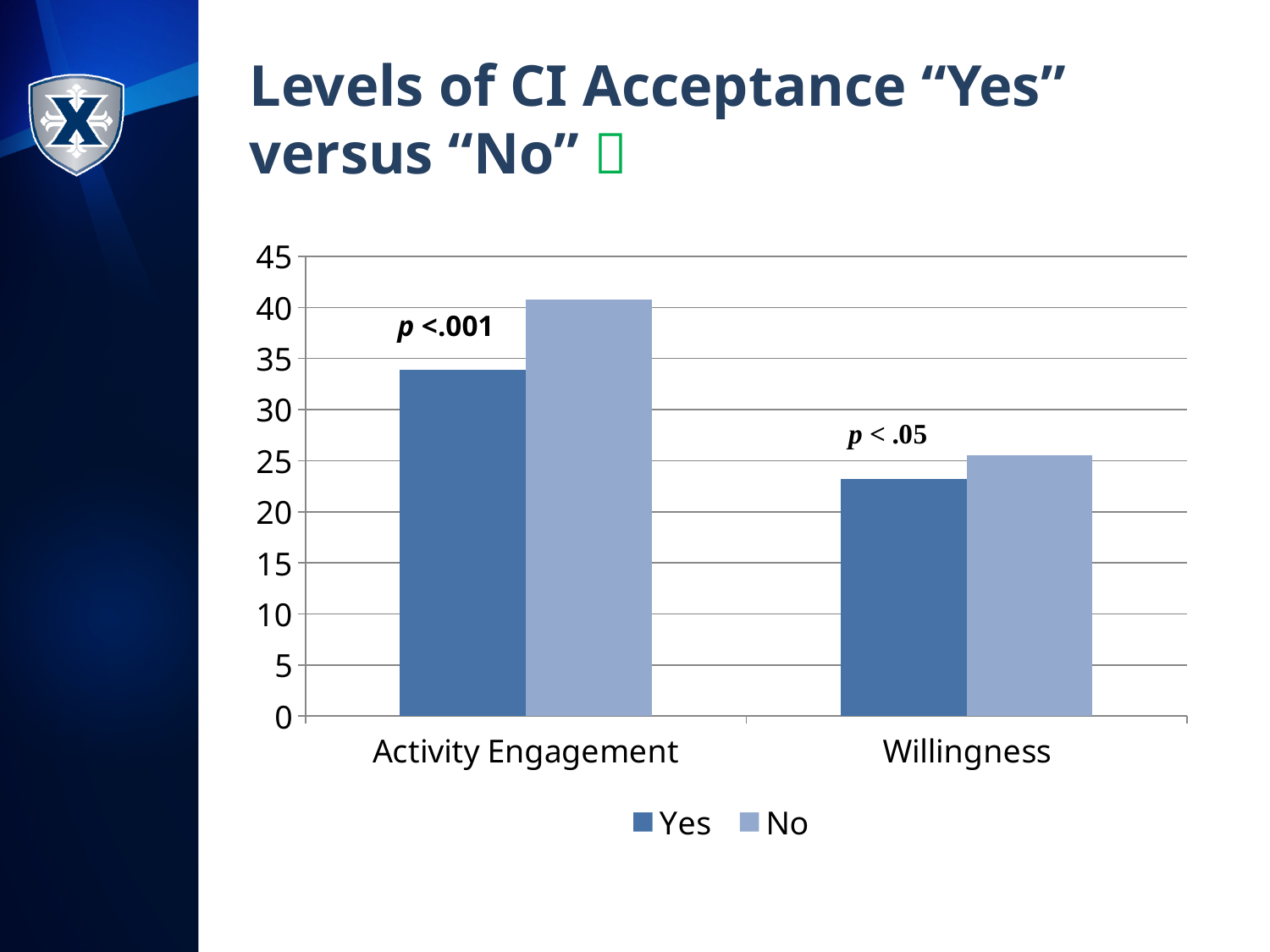
Is the Yes value for Activity Engagement greater or less than 30? greater How many series does the legend list? 2 What kind of chart is shown on the slide? bar chart Which bar is the tallest in the chart? No, Activity Engagement What p-value annotation is shown above the Willingness bars? p < .05 How many categories are shown on the x axis? 2 Which bar is the shortest in the chart? Yes, Willingness Is the No value for Activity Engagement greater or less than 35? greater For Activity Engagement, which is larger, the Yes value or the No value? No What p-value annotation is shown above the Activity Engagement bars? p <.001 Is the Yes value for Willingness greater or less than 25? less